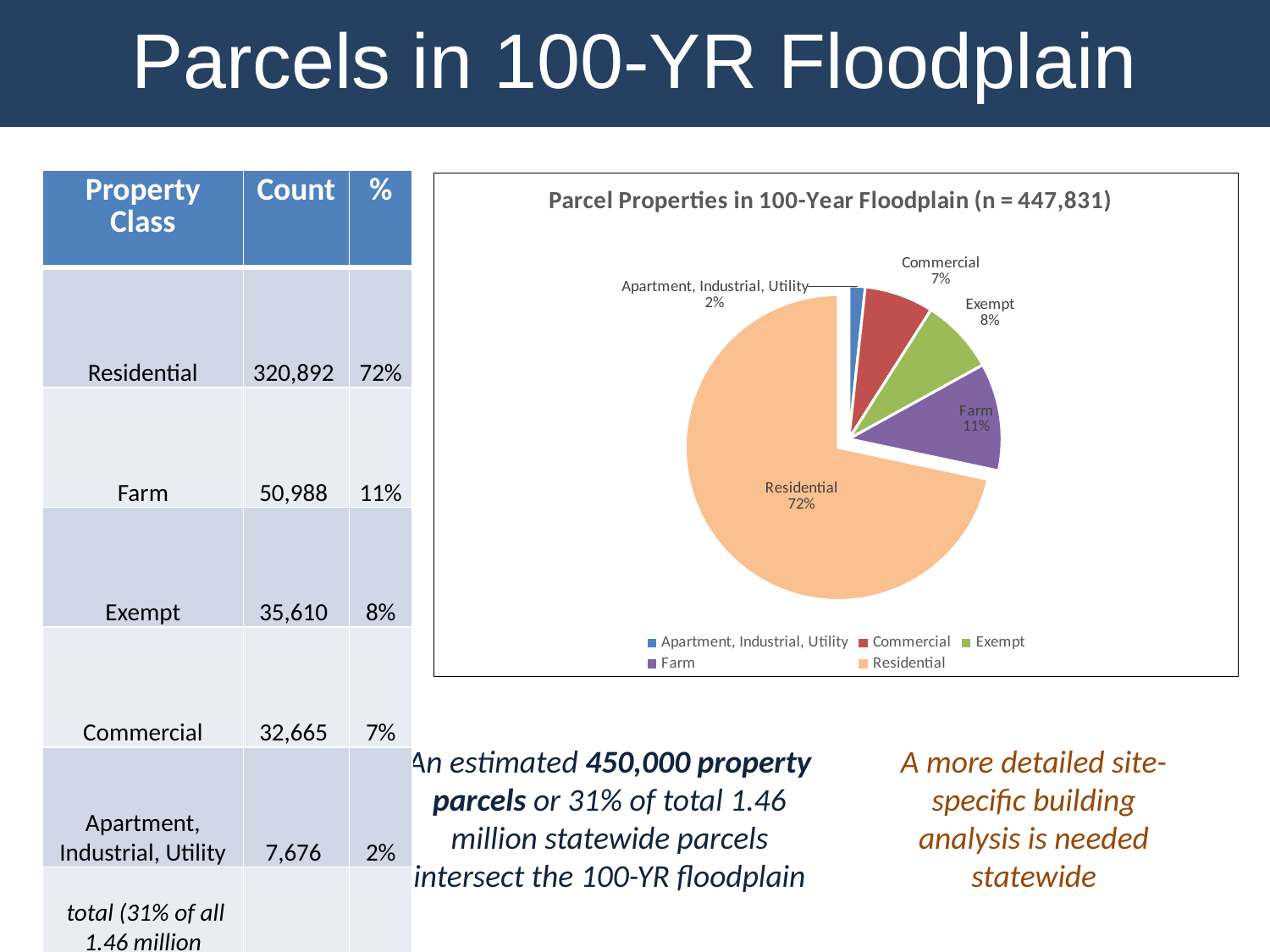
Which slice is larger, Farm or Exempt? Farm What share of the pie does Commercial represent? 7% What kind of chart is shown on the slide? pie chart What is the value of n given in the chart title? 447,831 Which category has the smallest slice of the pie? Apartment, Industrial, Utility What share of the pie does Farm represent? 11% What share of the pie does Residential represent? 72% What is the difference in percentage points between the Residential and Farm slices? 61 Which category has the largest slice of the pie? Residential How many slices does the pie chart have? 5